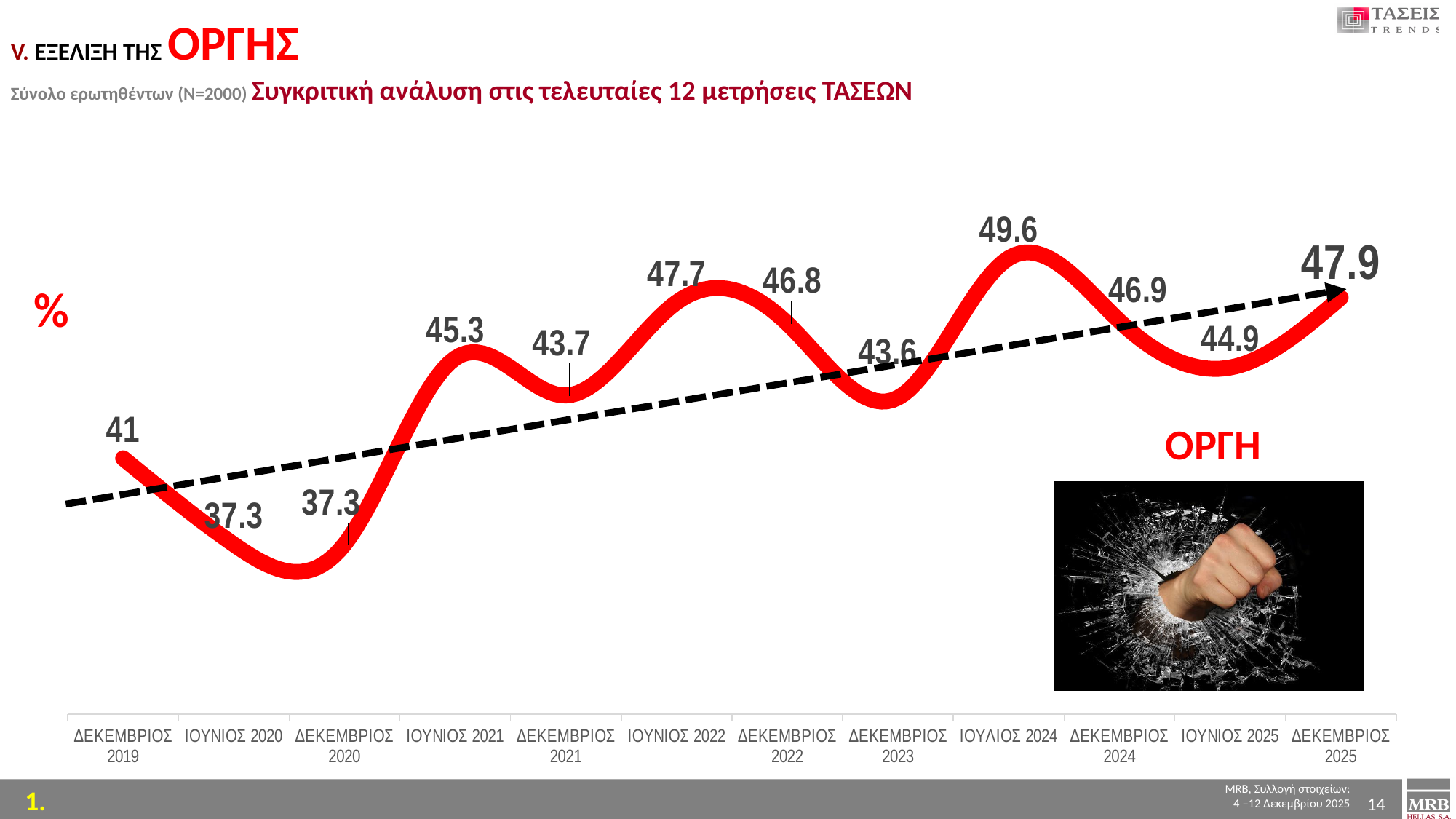
What is the value for ΙΟΥΝΙΟΣ 2022? 47.7 What is the value for ΔΕΚΕΜΒΡΙΟΣ 2019? 41 What kind of chart is shown on the slide? Line chart What is the value for ΙΟΥΛΙΟΣ 2024? 49.6 What is the difference between the values for ΔΕΚΕΜΒΡΙΟΣ 2025 and ΙΟΥΝΙΟΣ 2025? 3 What is the value for ΔΕΚΕΜΒΡΙΟΣ 2025? 47.9 What is the overall direction of the dashed trend line from ΔΕΚΕΜΒΡΙΟΣ 2019 to ΔΕΚΕΜΒΡΙΟΣ 2025? Rising What is the lowest value shown on the chart? 37.3 Which measurement has the highest value? ΙΟΥΛΙΟΣ 2024 Which is larger, the value for ΙΟΥΝΙΟΣ 2021 or the value for ΔΕΚΕΜΒΡΙΟΣ 2021? ΙΟΥΝΙΟΣ 2021 How many measurements (data points) are plotted on the chart? 12 What is the difference between the values for ΙΟΥΛΙΟΣ 2024 and ΔΕΚΕΜΒΡΙΟΣ 2024? 2.7